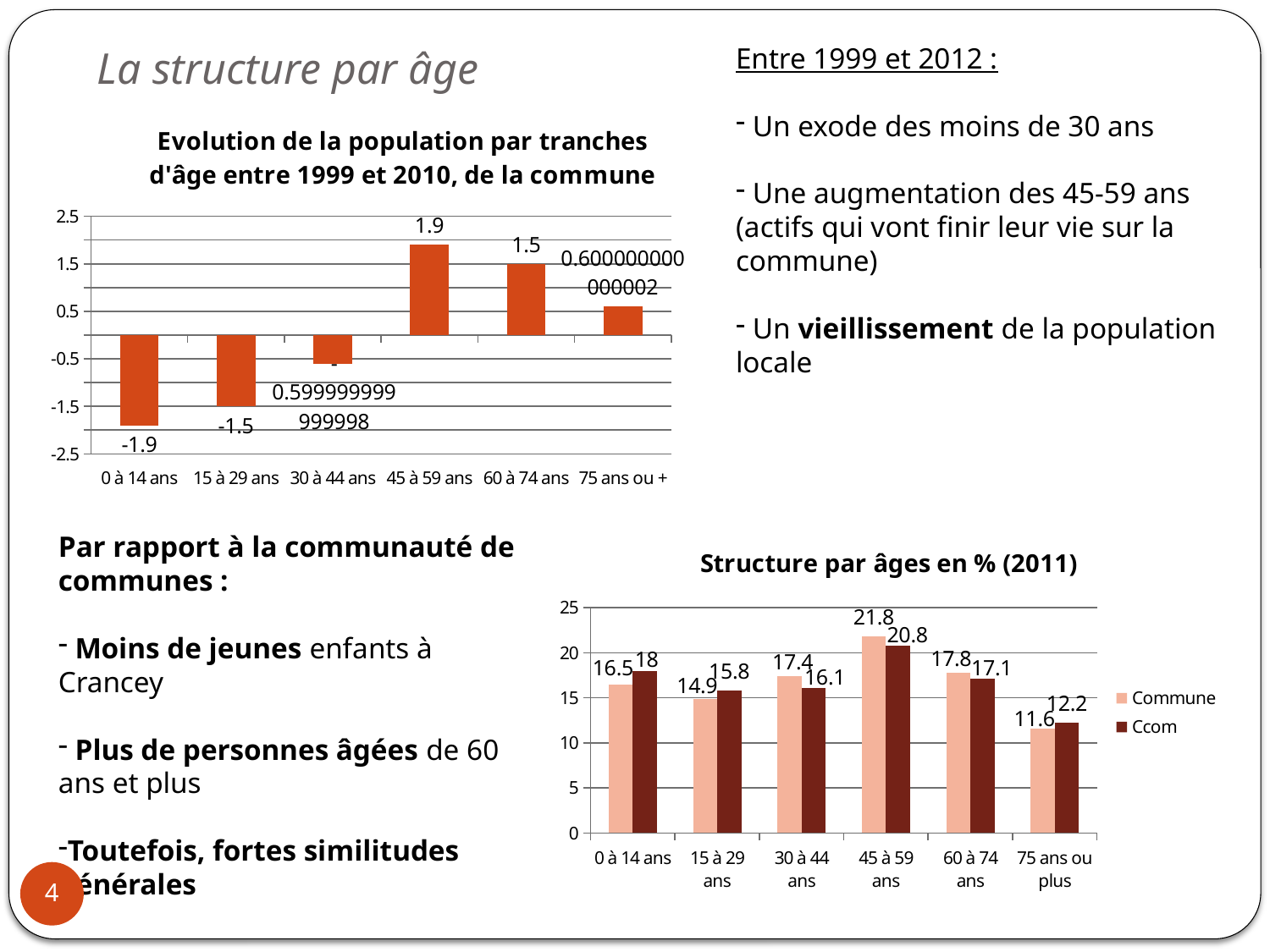
In the chart 'Structure par âges en % (2011)', which age group has the highest Commune value? 45 à 59 ans In the chart 'Evolution de la population par tranches d'âge entre 1999 et 2010, de la commune', what is the value for 0 à 14 ans? -1.9 In the chart 'Evolution de la population par tranches d'âge entre 1999 et 2010, de la commune', how many age groups are shown? 6 In the chart 'Structure par âges en % (2011)', what is the Ccom value for 75 ans ou plus? 12.2 In the chart 'Structure par âges en % (2011)', what is the Commune value for 45 à 59 ans? 21.8 In the chart 'Structure par âges en % (2011)', which is larger for 0 à 14 ans: Commune or Ccom? Ccom In the chart 'Evolution de la population par tranches d'âge entre 1999 et 2010, de la commune', which age group has the lowest value? 0 à 14 ans In the chart 'Evolution de la population par tranches d'âge entre 1999 et 2010, de la commune', what is the difference between the values for 45 à 59 ans and 60 à 74 ans? 0.4 In the chart 'Structure par âges en % (2011)', how many series does the legend list? 2 In the chart 'Evolution de la population par tranches d'âge entre 1999 et 2010, de la commune', what is the value for 45 à 59 ans? 1.9 What type of chart is 'Structure par âges en % (2011)'? Bar chart In the chart 'Structure par âges en % (2011)', what is the difference between the Commune and Ccom values for 15 à 29 ans? 0.9